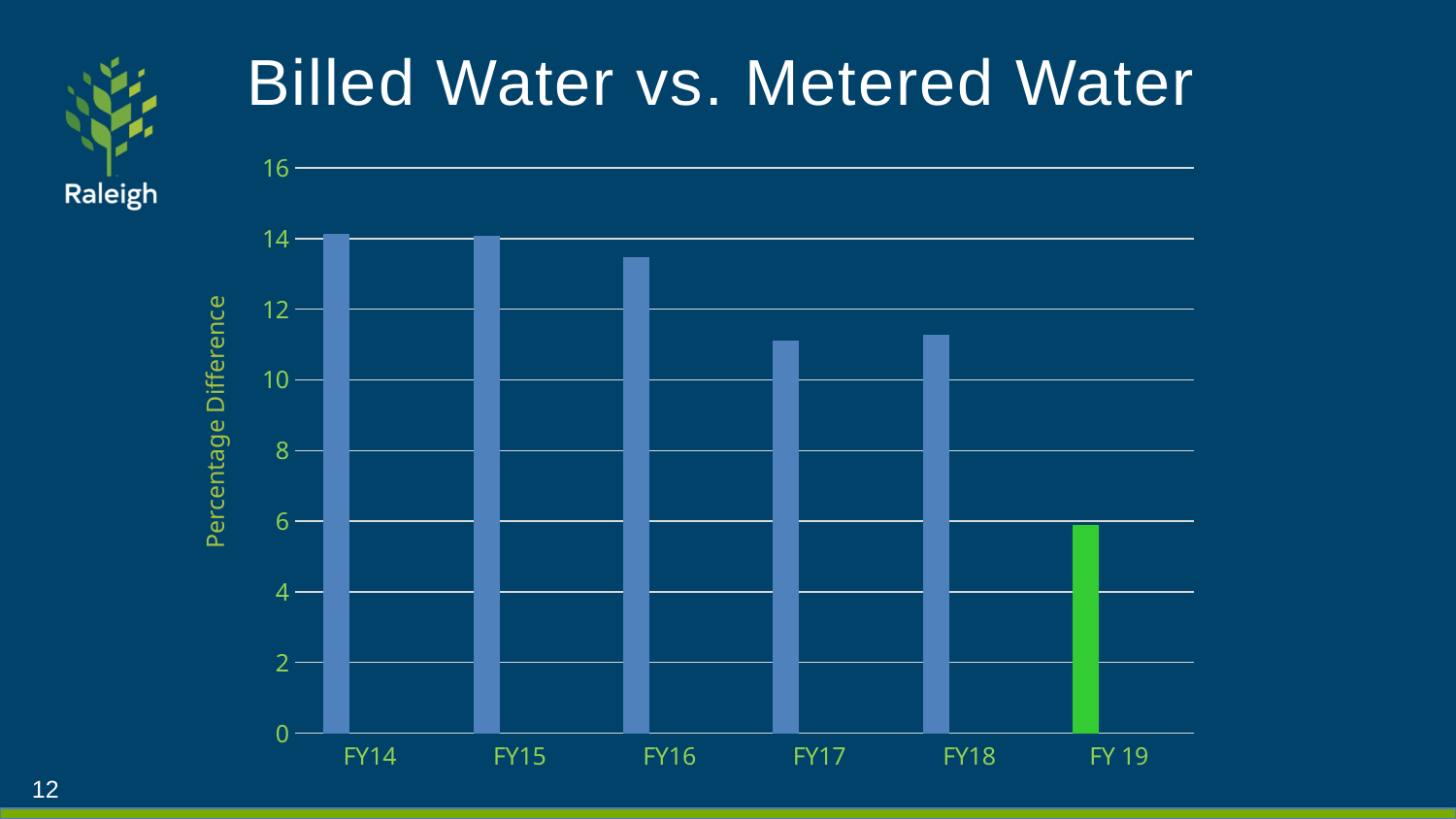
What is the title of the chart? Billed Water vs. Metered Water How many fiscal years are plotted on the chart? 6 Which is larger, the value for FY16 or the value for FY17? FY16 Is the value for FY17 greater or less than 10? greater What kind of chart is shown on the slide? bar chart Is the value for FY16 greater or less than 12? greater Is the value for FY18 greater or less than 12? less Which is larger, the value for FY14 or the value for FY 19? FY14 Which fiscal year has the lowest percentage difference? FY 19 Do the values generally rise or fall from FY14 to FY 19? fall